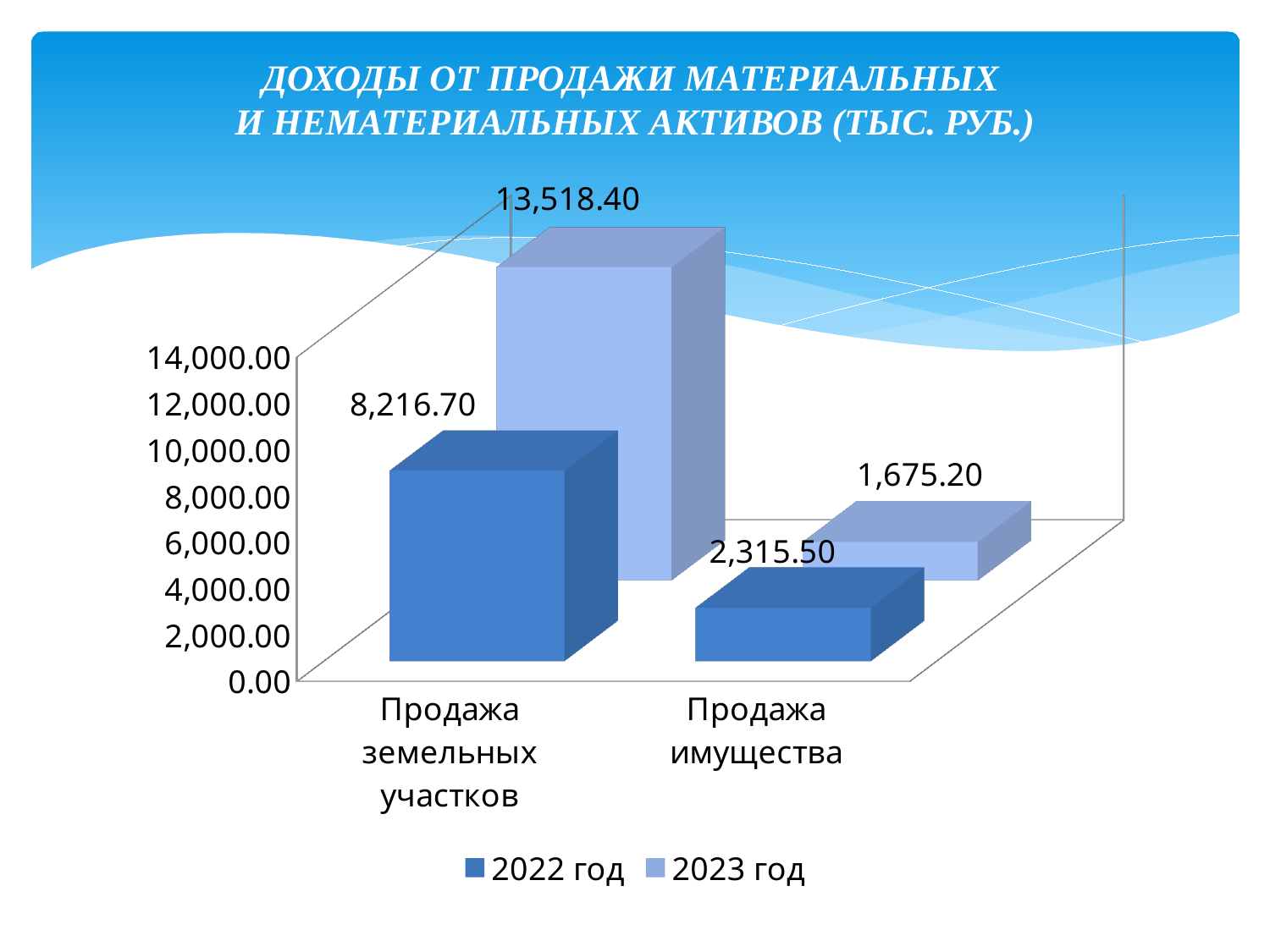
How many series does the legend list? 2 What is the difference between the 2023 год and 2022 год values for Продажа земельных участков? 5,301.70 What kind of chart is shown on the slide? Bar chart What is the difference between the 2022 год and 2023 год values for Продажа имущества? 640.30 How many categories are shown on the x axis? 2 What is the value for Продажа земельных участков in the 2022 год series? 8,216.70 For Продажа имущества, which series has the larger value, 2022 год or 2023 год? 2022 год What is the value for Продажа земельных участков in the 2023 год series? 13,518.40 What is the value for Продажа имущества in the 2023 год series? 1,675.20 What is the value for Продажа имущества in the 2022 год series? 2,315.50 Which category has the lowest value in the 2022 год series? Продажа имущества Which category has the highest value in the 2023 год series? Продажа земельных участков